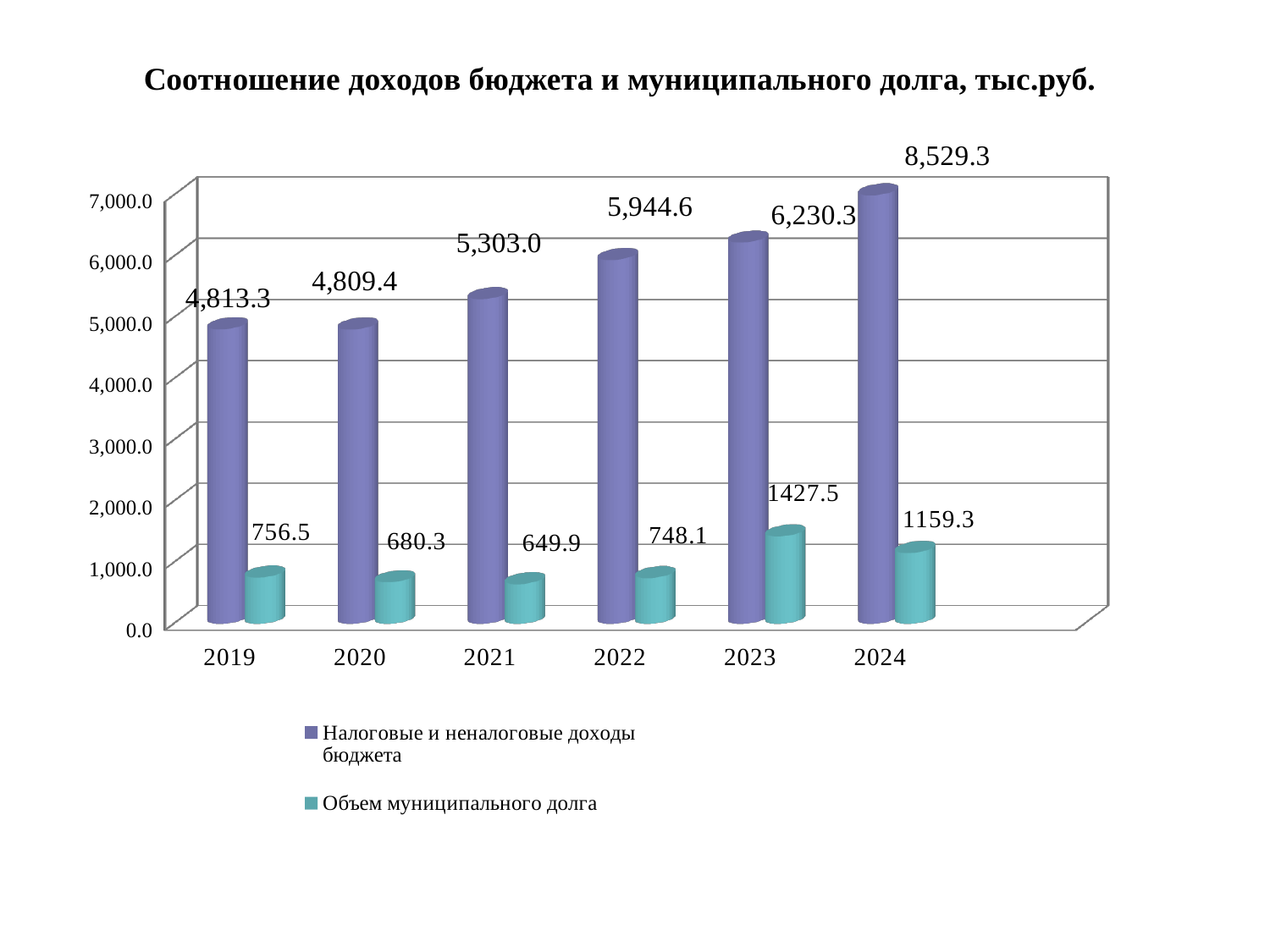
What kind of chart is shown on the slide? bar chart What is the value of Налоговые и неналоговые доходы бюджета for 2021? 5,303.0 Which is larger: Объем муниципального долга in 2023 or in 2024? 2023 How many series does the legend list? 2 What is the difference between Налоговые и неналоговые доходы бюджета in 2024 and in 2023? 2,299.0 What is the difference between Объем муниципального долга in 2023 and in 2022? 679.4 In which year is Объем муниципального долга the lowest? 2021 Is the value of Налоговые и неналоговые доходы бюджета for 2022 greater or less than 5,000.0? greater In which year is Налоговые и неналоговые доходы бюджета the highest? 2024 What is the value of Налоговые и неналоговые доходы бюджета for 2024? 8,529.3 How many years are shown on the x axis? 6 What is the value of Объем муниципального долга for 2023? 1427.5